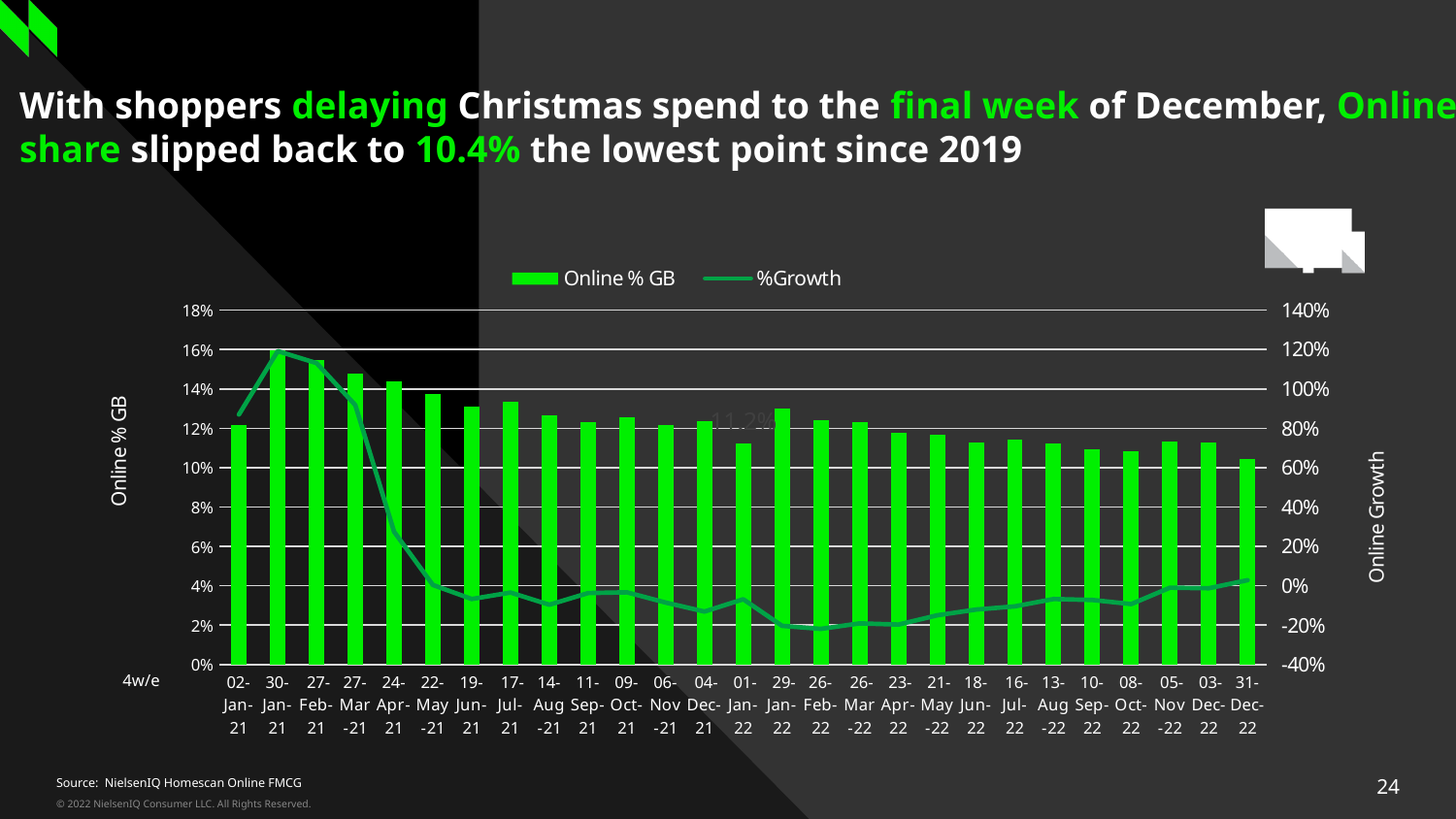
Is the Online % GB value for 30-Jan-21 greater or less than 14%? greater What kind of chart is shown on the slide? A combined bar and line chart How many 4w/e periods are plotted along the x axis? 27 Does Online % GB generally rise or fall from the start of 2021 to the end of 2022? fall Is the Online % GB value for 31-Dec-22 greater or less than 12%? less Which period has the highest Online % GB bar? 30-Jan-21 What are the two series named in the chart legend? Online % GB and %Growth How many series does the chart legend list? 2 Is the %Growth value for 26-Feb-22 greater or less than 0%? less Which is larger, the Online % GB bar for 30-Jan-21 or for 31-Dec-22? 30-Jan-21 According to the slide title, what value did Online share slip back to? 10.4% Which period has the lowest Online % GB bar? 31-Dec-22